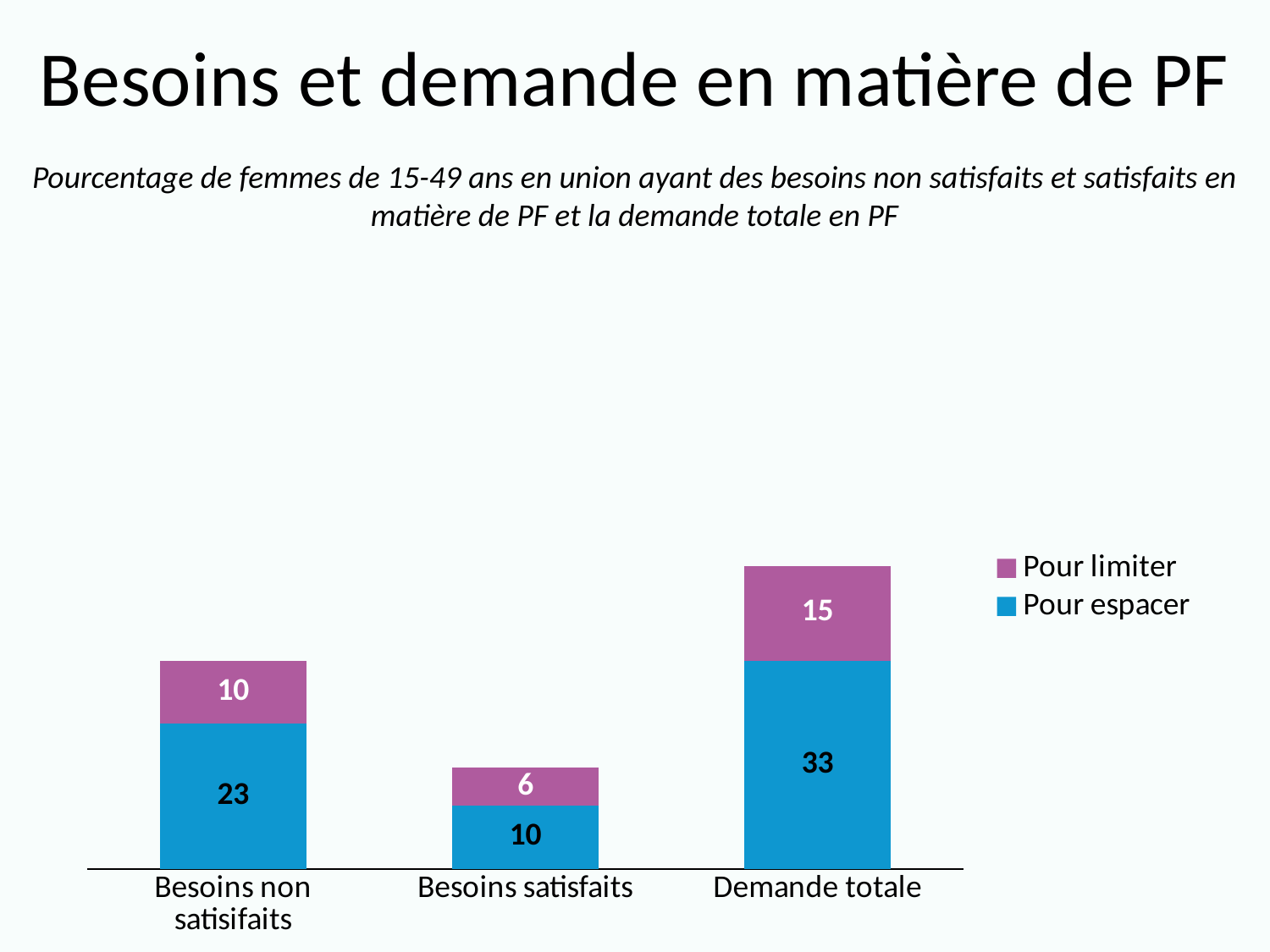
What is the value of 'Pour espacer' for 'Besoins satisfaits'? 10 What is the value of 'Pour espacer' for 'Besoins non satisifaits'? 23 What is the value of 'Pour limiter' for 'Demande totale'? 15 What is the value of 'Pour limiter' for 'Besoins satisfaits'? 6 How many categories are shown on the x axis? 3 How many series does the legend list? 2 What is the difference between the 'Pour espacer' values for 'Demande totale' and 'Besoins non satisifaits'? 10 Which category has the lowest 'Pour limiter' value? Besoins satisfaits What is the total of the stacked bar for 'Demande totale'? 48 Which is larger: 'Pour limiter' for 'Besoins non satisifaits' or 'Pour limiter' for 'Besoins satisfaits'? Besoins non satisifaits What is the total of the stacked bar for 'Besoins satisfaits'? 16 Which category has the highest 'Pour espacer' value? Demande totale